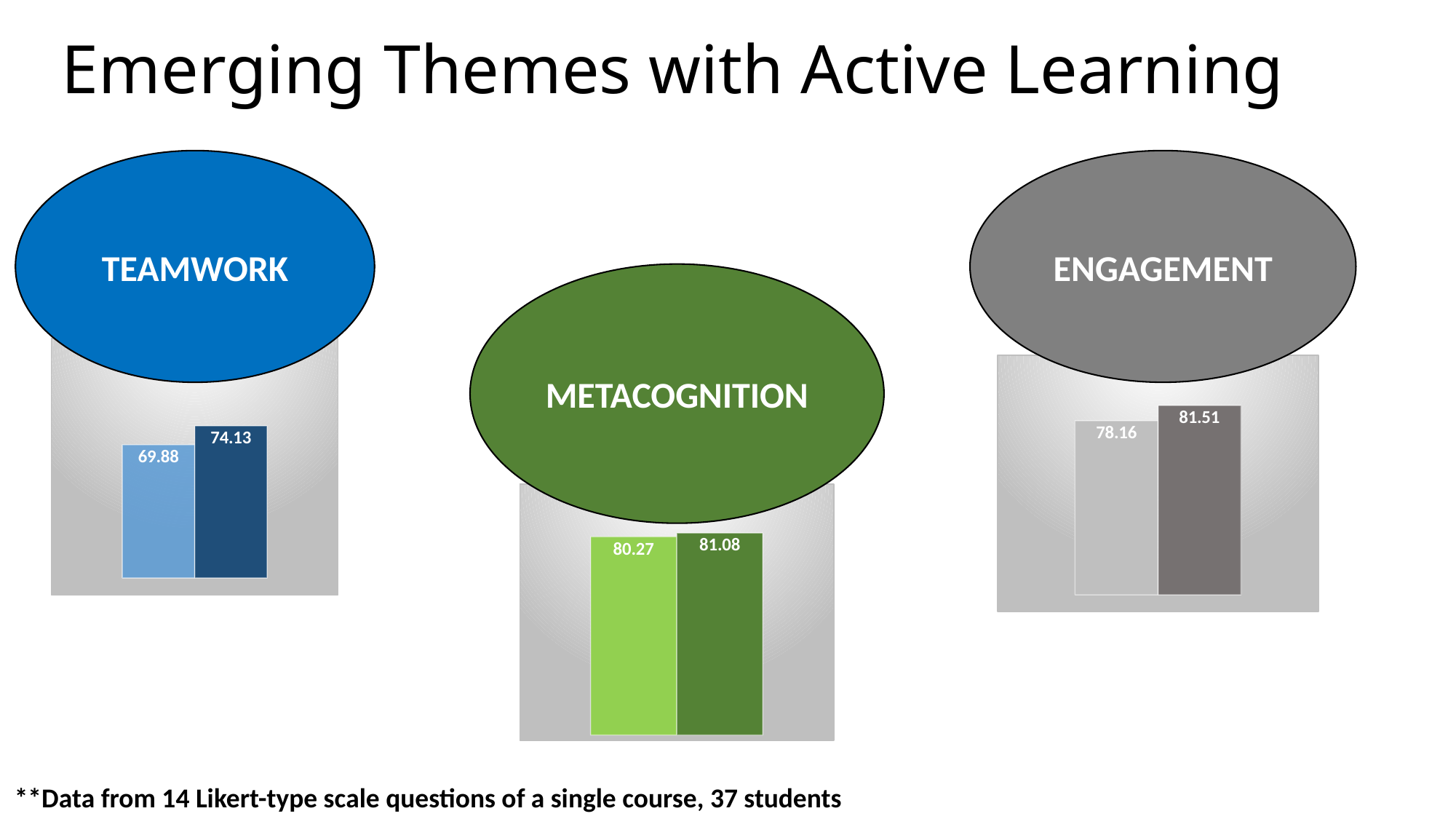
In the Teamwork chart, which bar is larger, the left bar or the right bar? the right bar In the Engagement chart, what value is printed on the right (dark grey) bar? 81.51 In the Engagement chart, what value is printed on the left (light grey) bar? 78.16 What kind of chart is used under each theme on the slide? bar chart In the Metacognition chart, what value is printed on the right (dark green) bar? 81.08 In the Metacognition chart, what is the difference between the right bar and the left bar? 0.81 In the Metacognition chart, what value is printed on the left (light green) bar? 80.27 How many bars are shown in the Engagement chart? 2 In the Teamwork chart, what is the difference between the right bar and the left bar? 4.25 In the Teamwork chart, what value is printed on the right (darker blue) bar? 74.13 In the Teamwork chart, what value is printed on the left (lighter blue) bar? 69.88 In the Engagement chart, what is the difference between the right bar and the left bar? 3.35